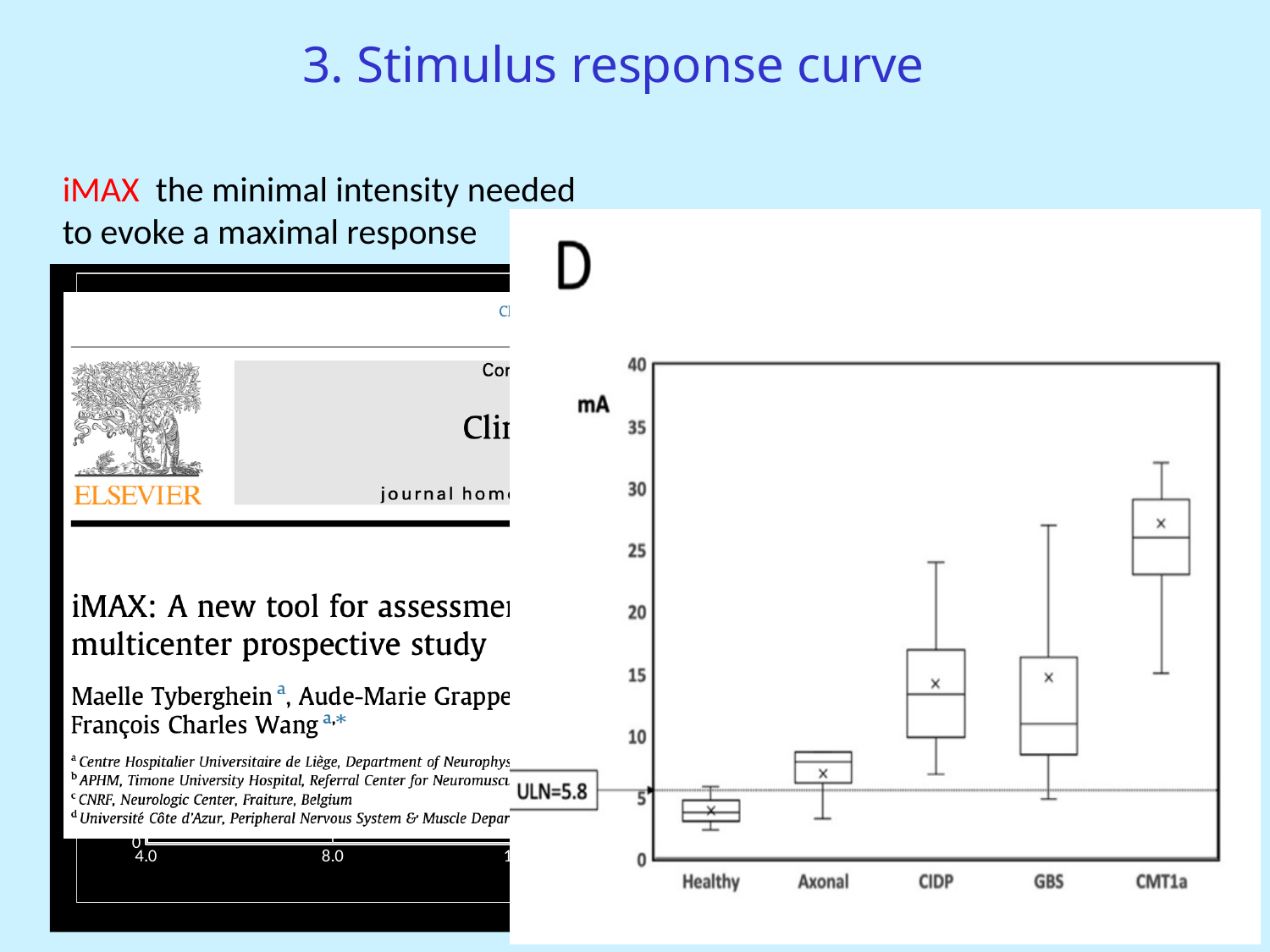
Which group has the lowest iMAX values in the box plot? Healthy Is the mean (x marker) for Healthy greater or less than 5 mA? less How many patient groups are shown along the x axis of the box plot? 5 Is the mean (x marker) for CMT1a greater or less than 25 mA? greater Which group has higher iMAX values, CIDP or Healthy? CIDP What is the ULN value marked by the dotted line on the box plot? ULN=5.8 What unit is shown on the y axis of the box plot? mA Is the mean (x marker) for CIDP greater or less than 10 mA? greater Which group has the highest iMAX values in the box plot? CMT1a Do the iMAX values generally rise or fall from Healthy to CMT1a along the x axis? rise What kind of chart is panel D on the slide? box plot